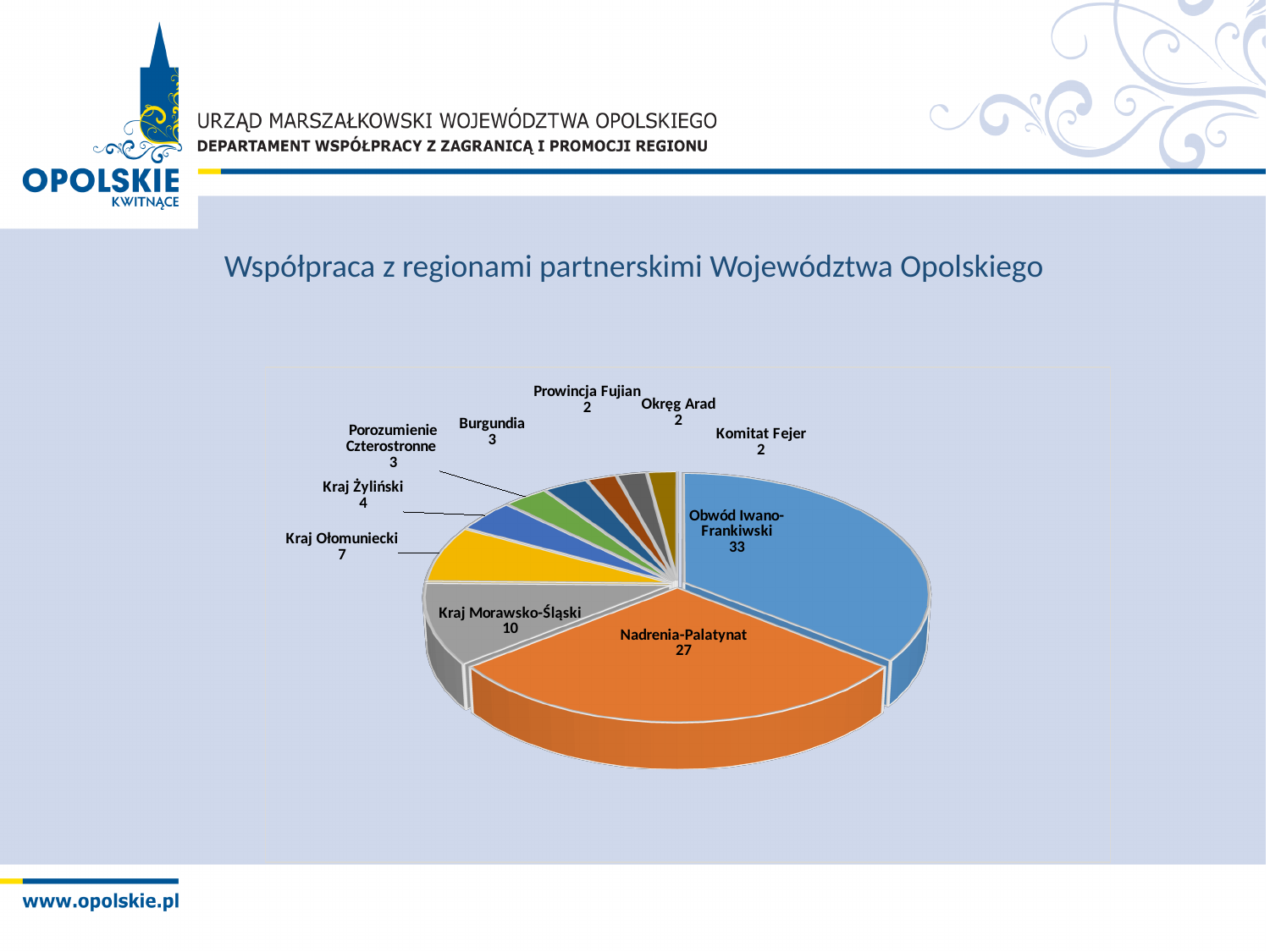
What is the value for Obwód Iwano-Frankiwski? 33 What is the value for Kraj Żyliński? 4 What type of chart is shown on the slide? Pie chart What is the sum of all the slice values in the pie chart? 93 What is the difference between the values for Obwód Iwano-Frankiwski and Nadrenia-Palatynat? 6 Which is larger, the value for Kraj Morawsko-Śląski or the value for Kraj Ołomuniecki? Kraj Morawsko-Śląski What is the value for Kraj Morawsko-Śląski? 10 Which region has the largest slice of the pie? Obwód Iwano-Frankiwski How many slices does the pie chart have? 10 What is the value for Nadrenia-Palatynat? 27 What is the value for Kraj Ołomuniecki? 7 What is the title of the slide above the chart? Współpraca z regionami partnerskimi Województwa Opolskiego